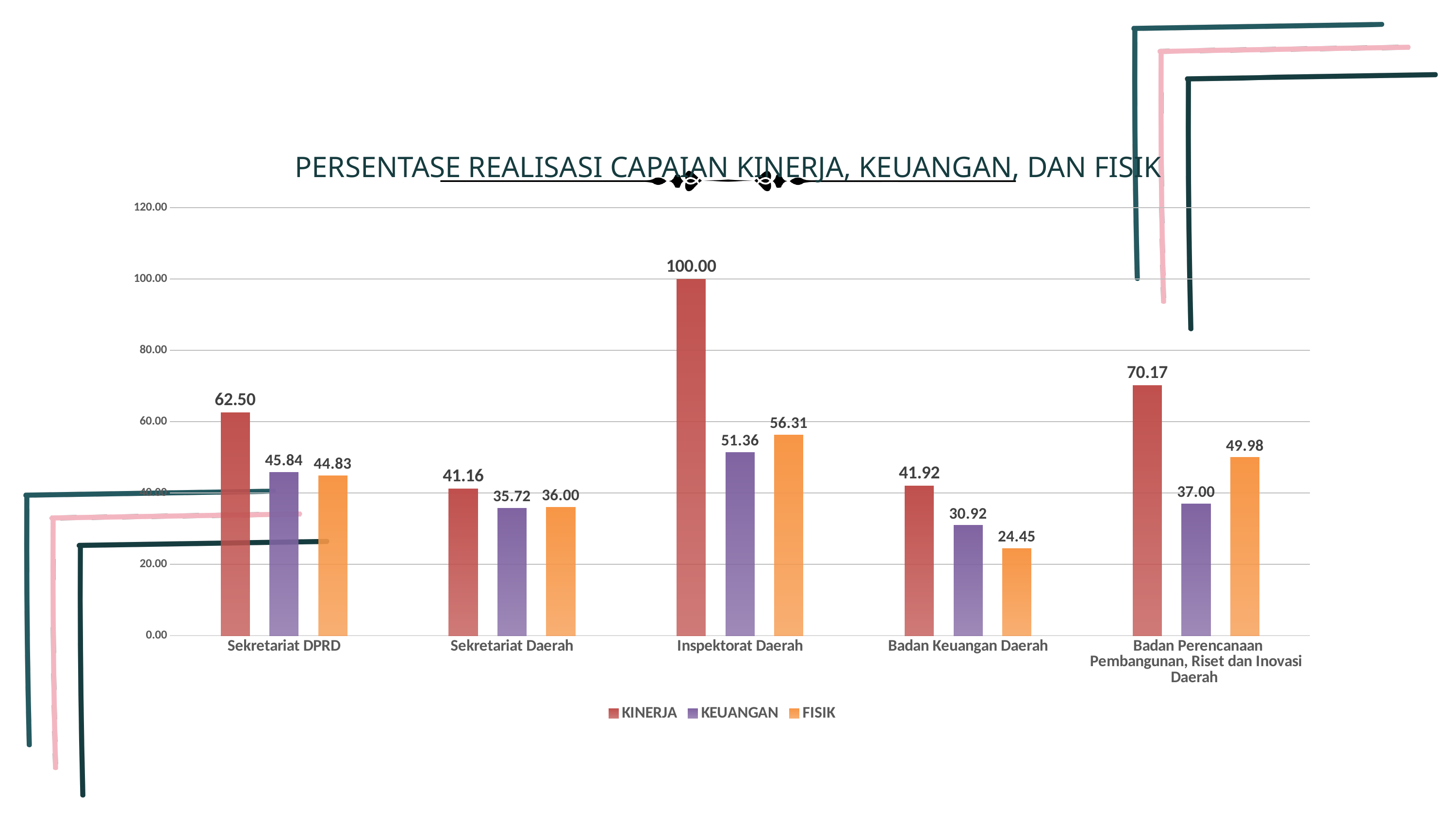
Is the KINERJA value for Badan Perencanaan Pembangunan, Riset dan Inovasi Daerah greater or less than 60.00? greater What is the KINERJA value for Inspektorat Daerah? 100.00 Which is larger for Badan Perencanaan Pembangunan, Riset dan Inovasi Daerah: the KEUANGAN value or the FISIK value? FISIK Which category has the highest KINERJA value? Inspektorat Daerah What is the KEUANGAN value for Sekretariat Daerah? 35.72 What is the difference between the KINERJA and KEUANGAN values for Sekretariat DPRD? 16.66 What is the title of the chart? PERSENTASE REALISASI CAPAIAN KINERJA, KEUANGAN, DAN FISIK How many categories are shown on the x axis? 5 What is the FISIK value for Badan Keuangan Daerah? 24.45 How many series does the legend list? 3 Which category has the lowest FISIK value? Badan Keuangan Daerah What kind of chart is shown on the slide? bar chart